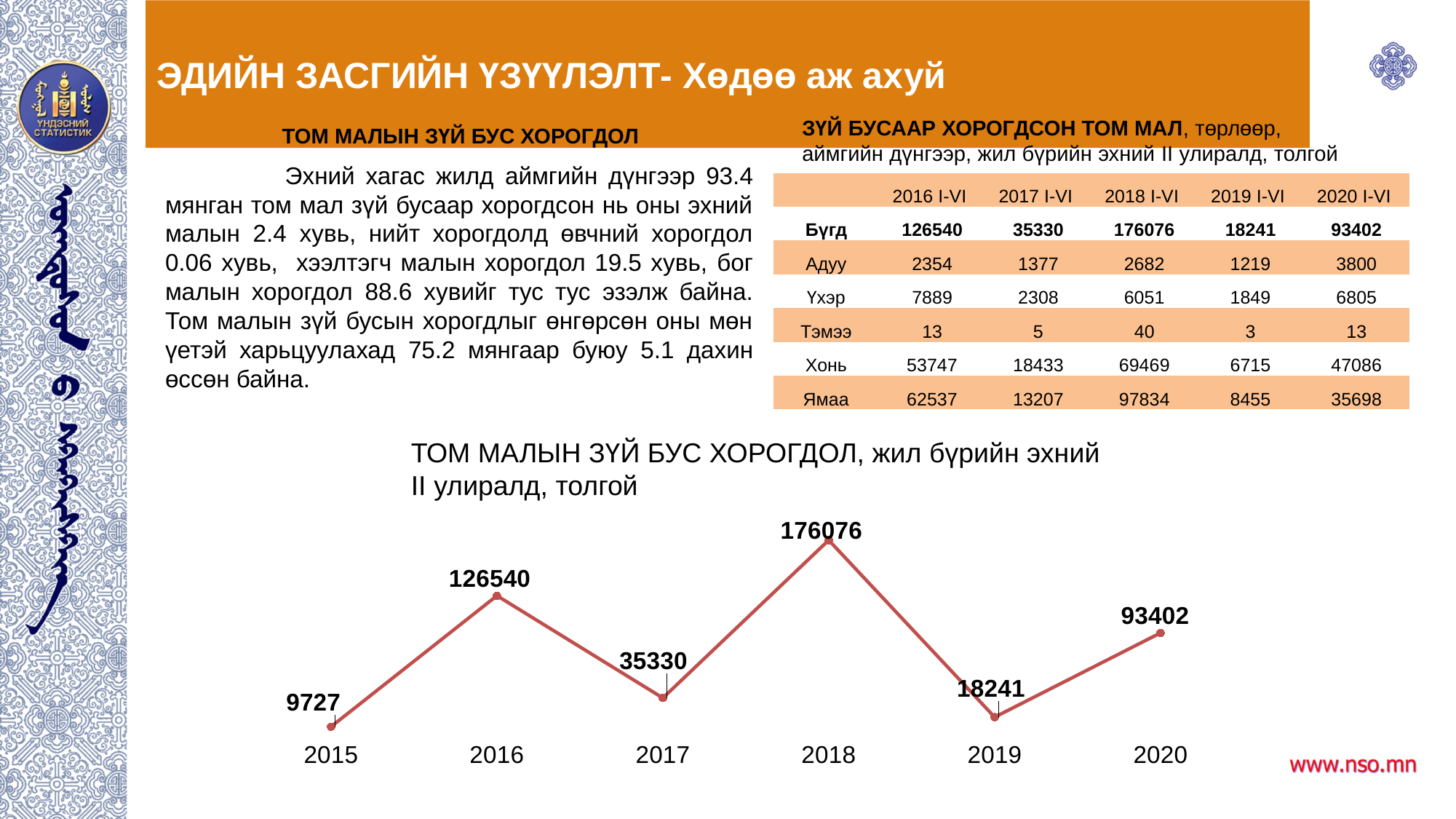
What is the difference between the values for 2018 and 2019? 157835 What is the value plotted for 2015? 9727 What type of chart is shown on the slide? line chart Which year has the highest value in the chart? 2018 What is the value plotted for 2017? 35330 Does the value rise or fall from 2019 to 2020? rise Which year has the lowest value in the chart? 2015 What is the value plotted for 2018? 176076 What is the difference between the values for 2016 and 2015? 116813 Which is larger, the value for 2016 or the value for 2020? 2016 How many years are plotted on the x axis of the chart? 6 What is the value plotted for 2020? 93402